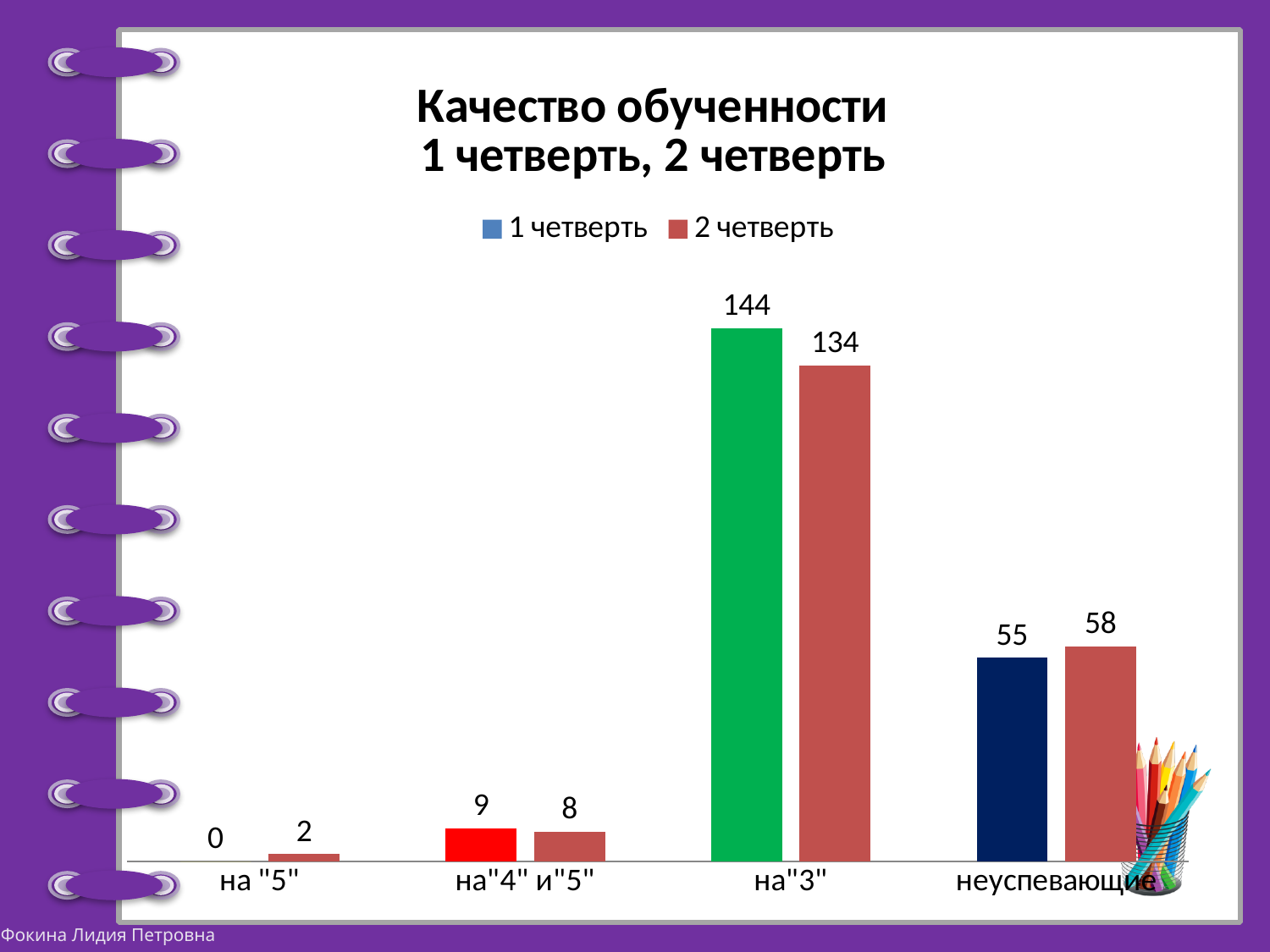
How many series does the legend list? 2 What is the value for на"3" in the 1 четверть series? 144 How many categories are shown on the x axis? 4 What is the difference between the 1 четверть and 2 четверть values for на"3"? 10 What is the value for на "5" in the 1 четверть series? 0 What kind of chart is shown on the slide? bar chart What is the value for на"4" и"5" in the 2 четверть series? 8 What is the value for неуспевающие in the 2 четверть series? 58 Which category has the highest value in the 2 четверть series? на"3" What is the title of the chart? Качество обученности 1 четверть, 2 четверть Which is larger for неуспевающие: the 1 четверть value or the 2 четверть value? 2 четверть Which category has the lowest value in the 1 четверть series? на "5"